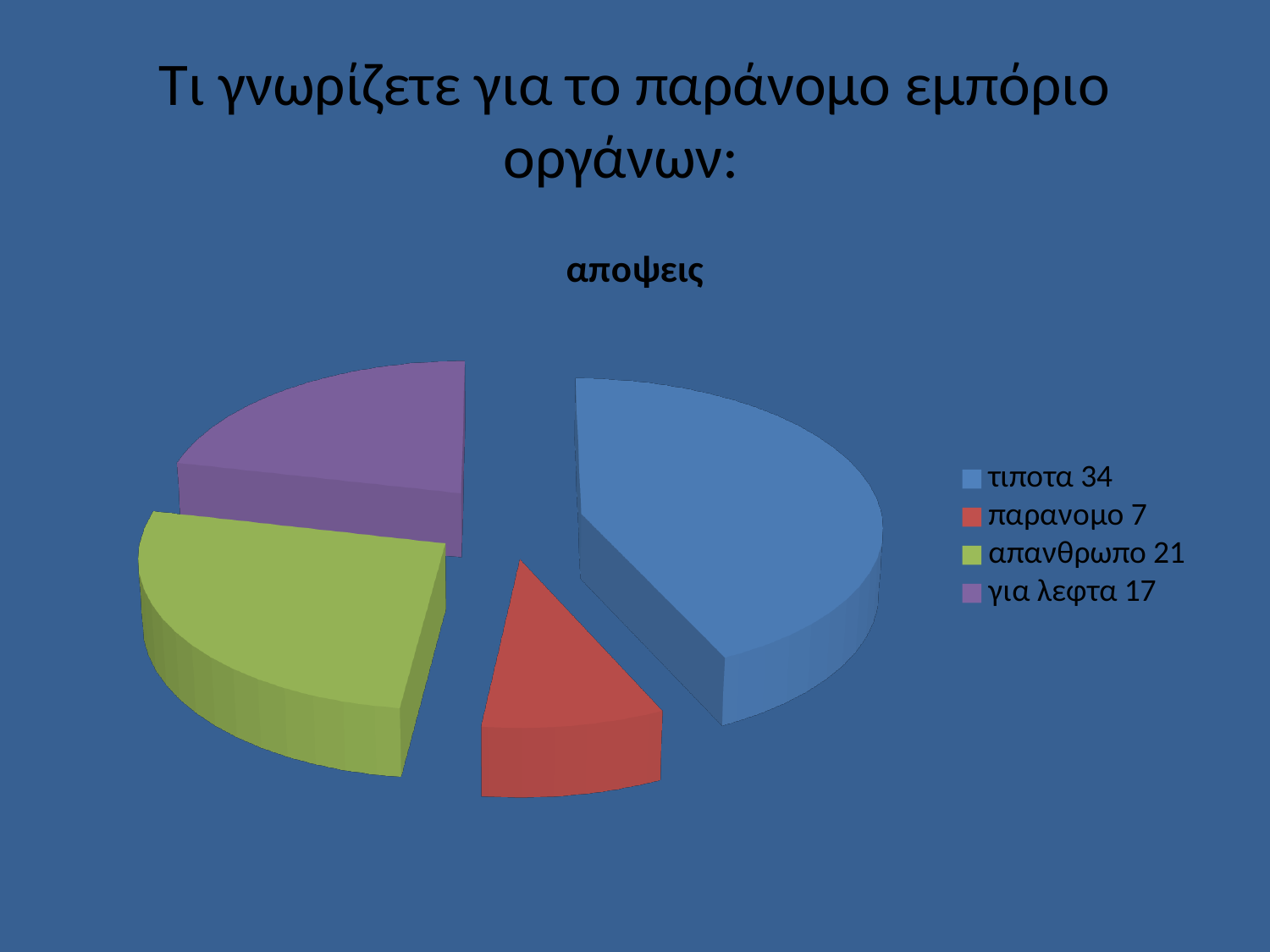
What is the value for για λεφτα? 17 Which is larger, the value for απανθρωπο or the value for για λεφτα? απανθρωπο Which category has the smallest slice? παρανομο What is the value for τιποτα? 34 What is the title of the chart? αποψεις What colour is the slice for για λεφτα? purple How many slices does the pie chart have? 4 What is the value for παρανομο? 7 What is the value for απανθρωπο? 21 What kind of chart is shown on the slide? pie chart Which category has the largest slice? τιποτα What is the difference between the values for τιποτα and απανθρωπο? 13